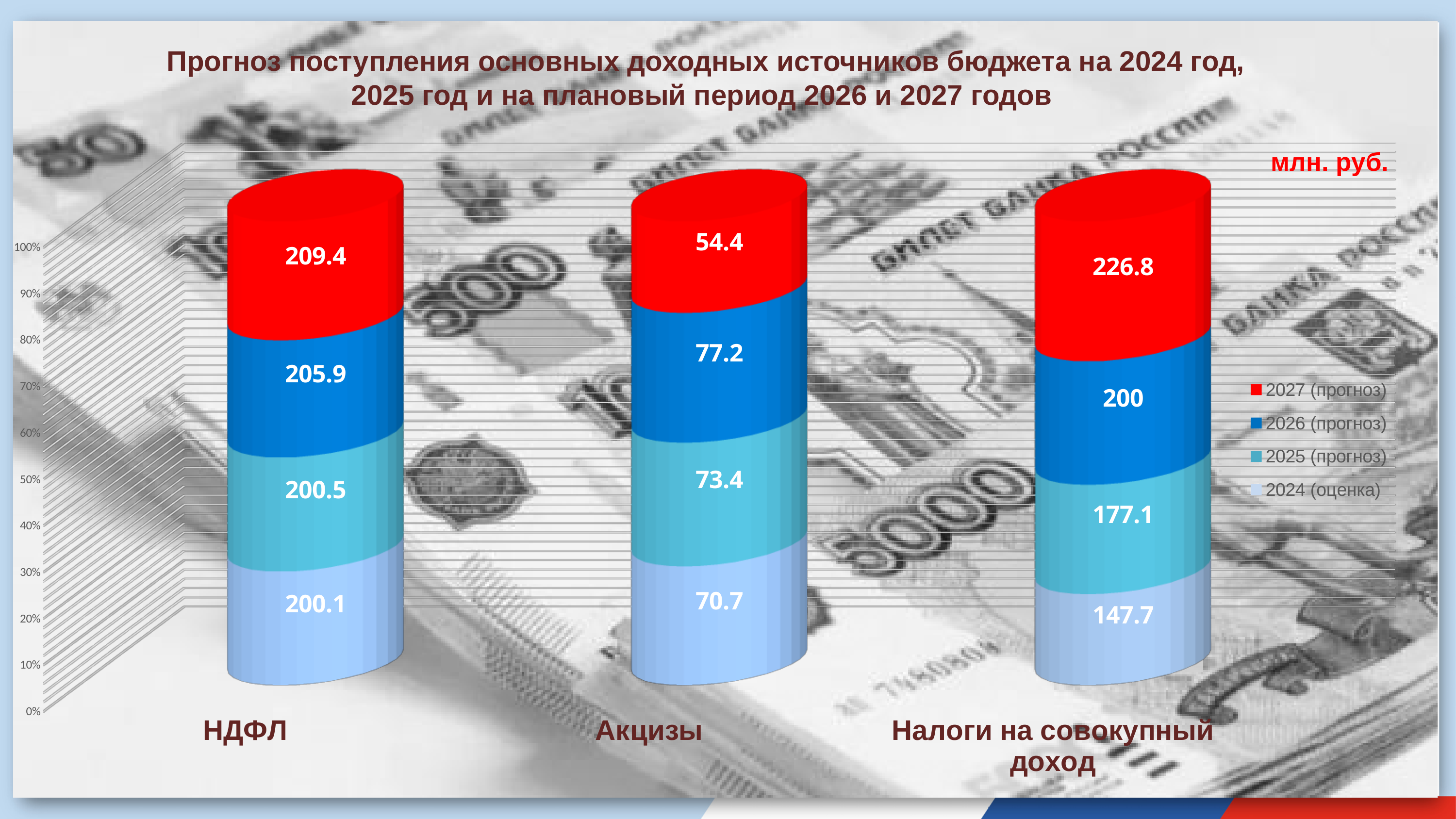
What is the value for НДФЛ in the 2027 (прогноз) series? 209.4 Which is larger for Акцизы: the 2026 (прогноз) value or the 2025 (прогноз) value? 2026 (прогноз) Do the values for НДФЛ rise or fall from 2024 (оценка) to 2027 (прогноз)? Rise How many series does the legend list? 4 How many categories are shown on the x axis? 3 What is the value for Налоги на совокупный доход in the 2025 (прогноз) series? 177.1 Which category has the lowest value in the 2024 (оценка) series? Акцизы What is the value for Налоги на совокупный доход in the 2026 (прогноз) series? 200 What is the difference between the 2027 (прогноз) and 2024 (оценка) values for Налоги на совокупный доход? 79.1 Which category has the highest value in the 2027 (прогноз) series? Налоги на совокупный доход What is the value for Акцизы in the 2024 (оценка) series? 70.7 What kind of chart is shown on the slide? Stacked bar chart